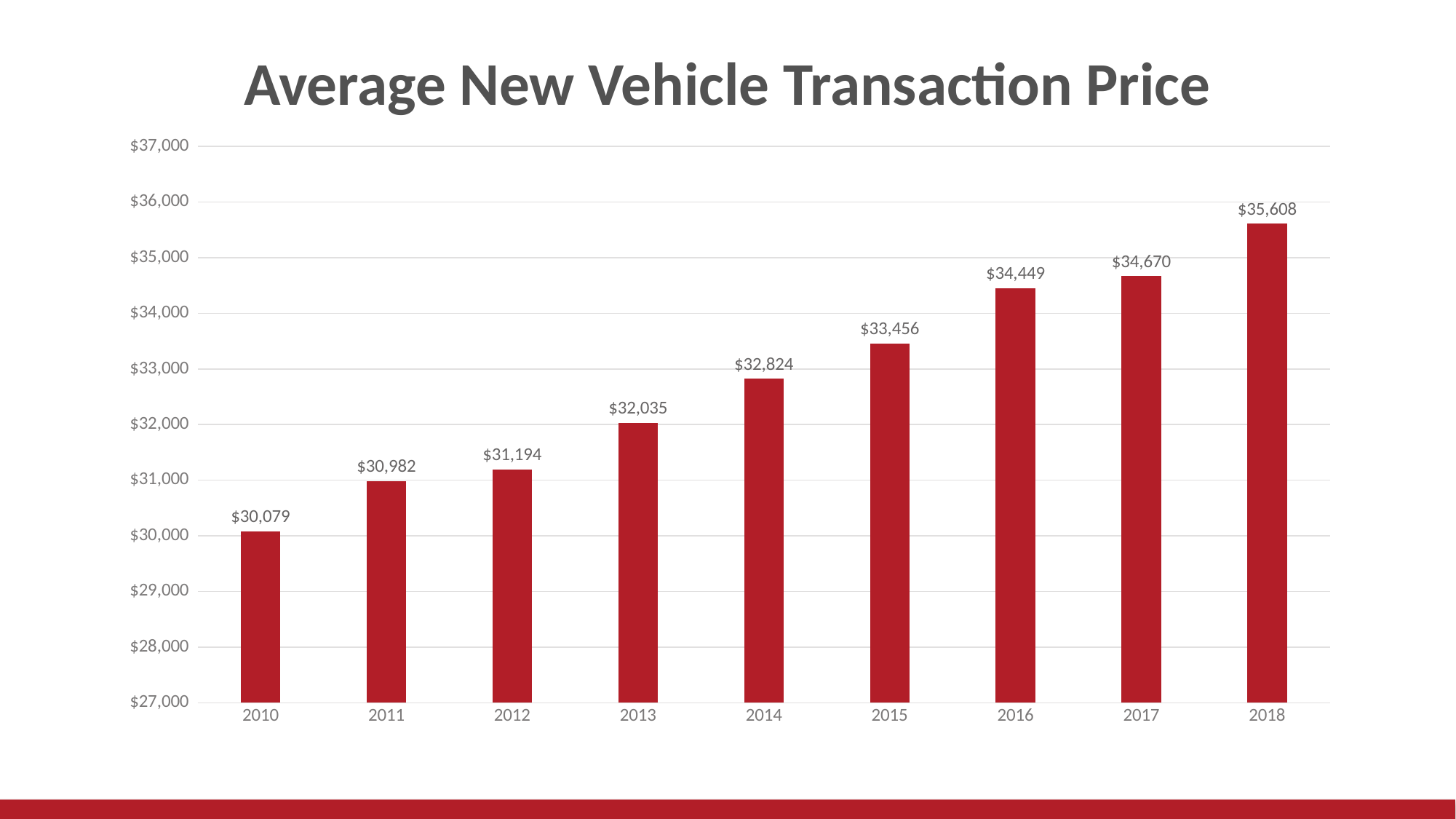
Is the average transaction price for 2015 greater or less than $33,000? greater Do the average transaction prices rise or fall from 2010 to 2018? Rise Which year had a higher average transaction price, 2012 or 2013? 2013 What kind of chart is shown on the slide? Bar chart How many years are shown on the chart? 9 What is the difference between the average transaction price in 2018 and in 2010? $5,529 What was the average new vehicle transaction price in 2017? $34,670 What was the average new vehicle transaction price in 2014? $32,824 What is the difference between the average transaction price in 2016 and in 2015? $993 Which year has the lowest average new vehicle transaction price? 2010 What was the average new vehicle transaction price in 2010? $30,079 Which year has the highest average new vehicle transaction price? 2018